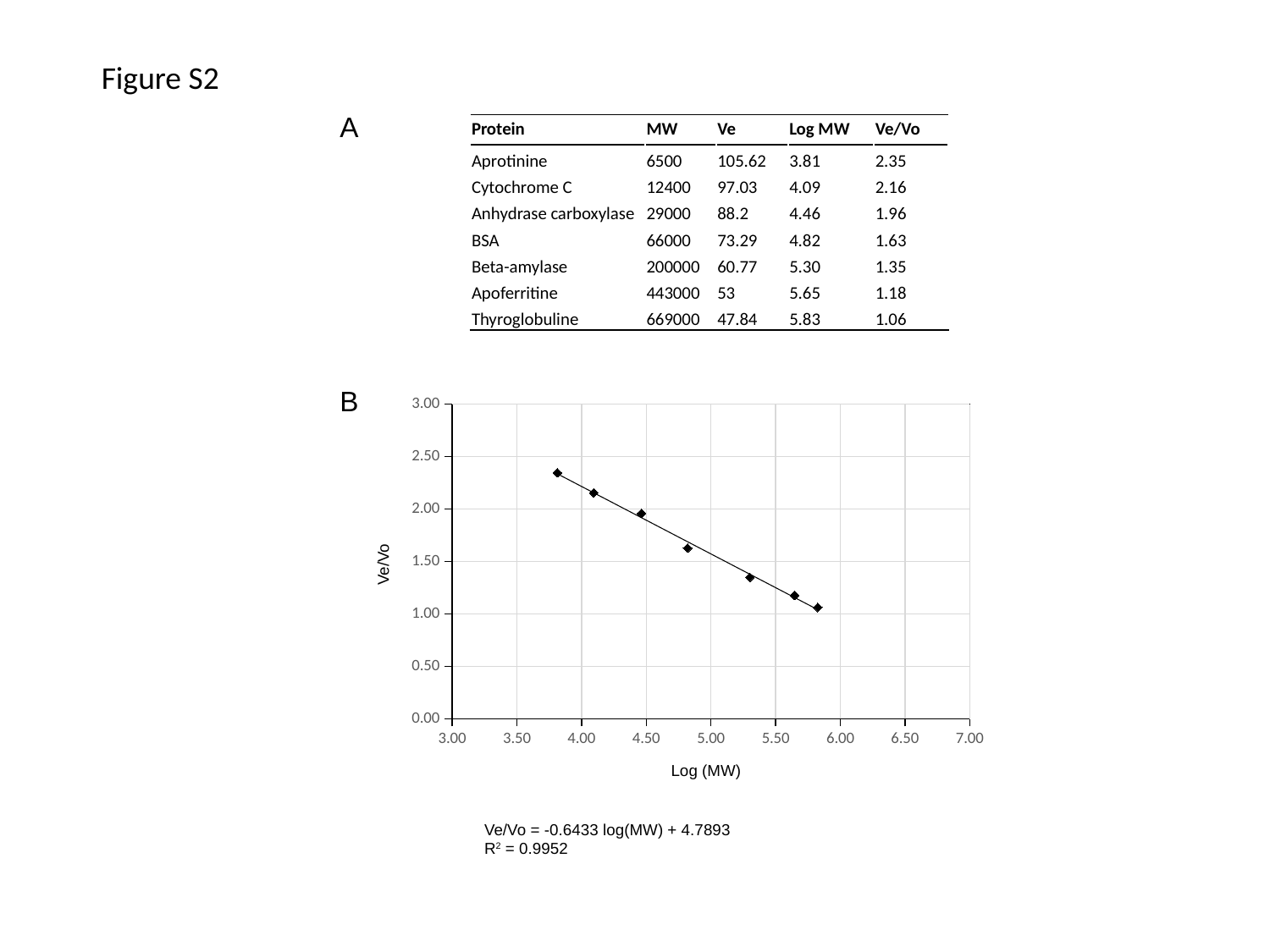
According to the table in panel A, what is the Ve/Vo value for BSA? 1.63 How many data points are plotted in the chart in panel B? 7 In the chart in panel B, is the Ve/Vo value of the leftmost point greater or less than 2.00? greater What R² value is given for the trend line in the chart in panel B? 0.9952 What is the slope of the trend line equation shown below the chart in panel B? -0.6433 What kind of chart is shown in panel B? scatter chart According to the table in panel A, which has the larger Ve/Vo value, Cytochrome C or Beta-amylase? Cytochrome C According to the table in panel A, which protein has the highest Ve/Vo value? Aprotinine In the chart in panel B, is the Ve/Vo value of the rightmost point greater or less than 1.50? less What is the y-axis title of the chart in panel B? Ve/Vo In the chart in panel B, do the Ve/Vo values rise or fall as Log (MW) increases? fall What is the x-axis title of the chart in panel B? Log (MW)